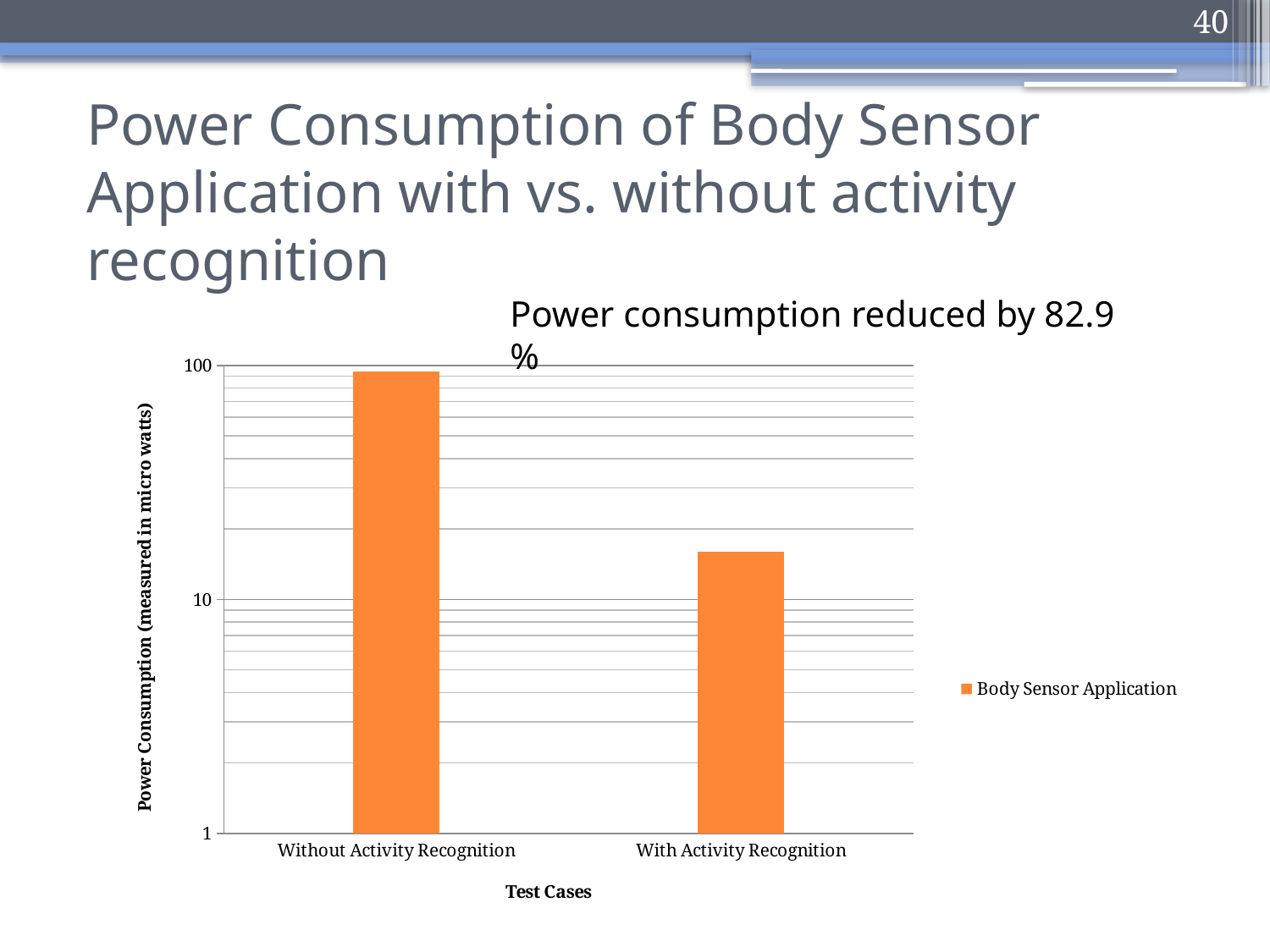
Which test case has the lowest power consumption? With Activity Recognition Is the value for Without Activity Recognition greater or less than 10? greater What is the title of the y axis? Power Consumption (measured in micro watts) Which test case has the highest power consumption? Without Activity Recognition Is the value for With Activity Recognition greater or less than 10? greater Is the value for With Activity Recognition greater or less than 100? less What kind of chart is shown on the slide? Bar chart How many test cases (categories) are plotted on the x axis? 2 What series name is shown in the legend? Body Sensor Application Do the values rise or fall from Without Activity Recognition to With Activity Recognition? fall How many series does the legend list? 1 Which has the larger power consumption: Without Activity Recognition or With Activity Recognition? Without Activity Recognition